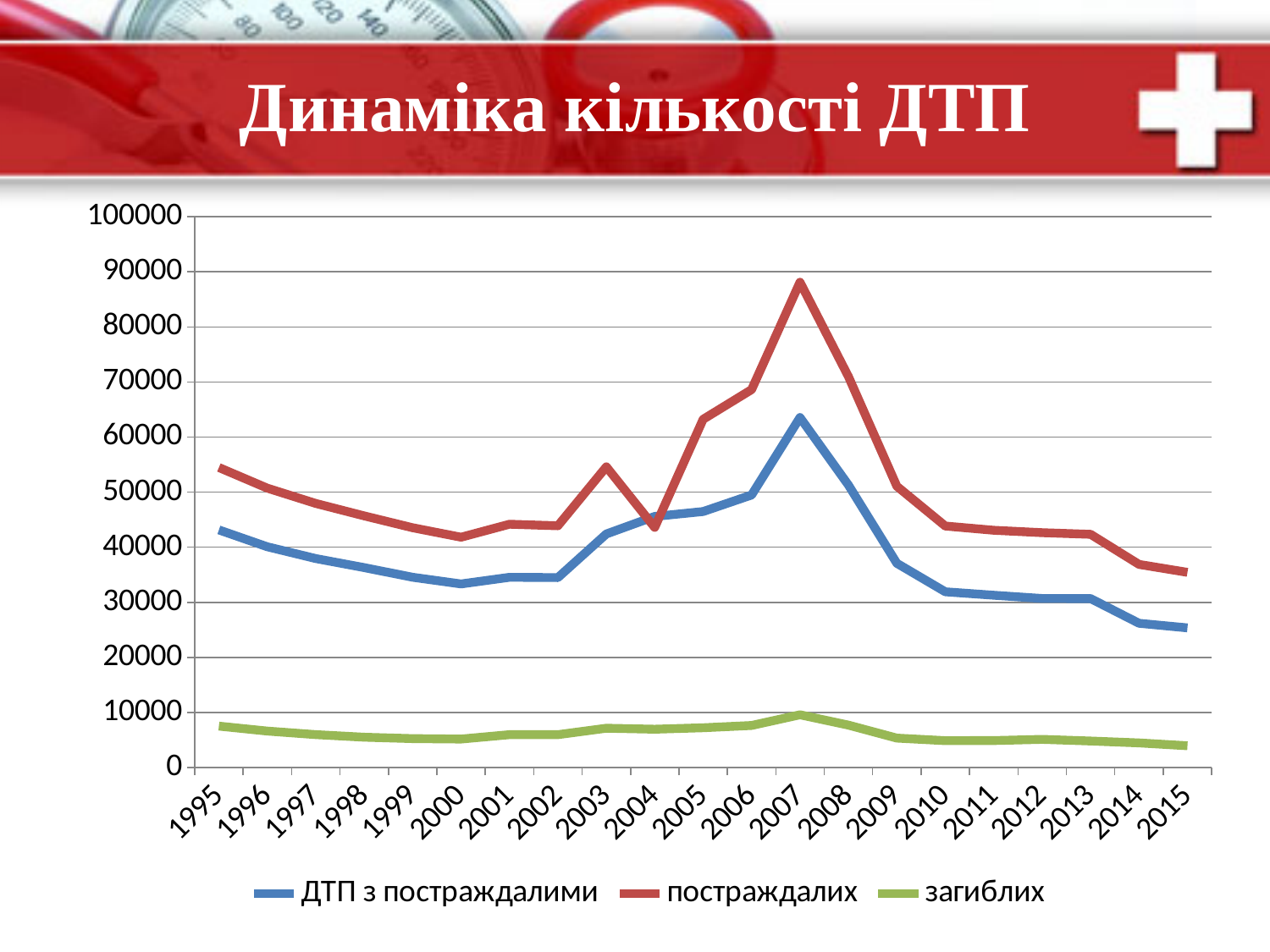
What is the title of the chart on the slide? Динаміка кількості ДТП Is the value for 'постраждалих' in 2007 greater or less than 80000? greater In which year does the 'ДТП з постраждалими' series reach its highest value? 2007 Is the value for 'ДТП з постраждалими' in 2015 greater or less than 30000? less What kind of chart is shown on the slide? line chart In which year does the 'постраждалих' series reach its highest value? 2007 In which year does the 'загиблих' series reach its highest value? 2007 How many series does the legend list? 3 How many years are plotted along the x axis? 21 Is the value for 'загиблих' in 2015 greater or less than 10000? less Do the values of the 'постраждалих' series rise or fall from 2007 to 2015? fall Which series has the larger value in 2007, 'постраждалих' or 'ДТП з постраждалими'? постраждалих